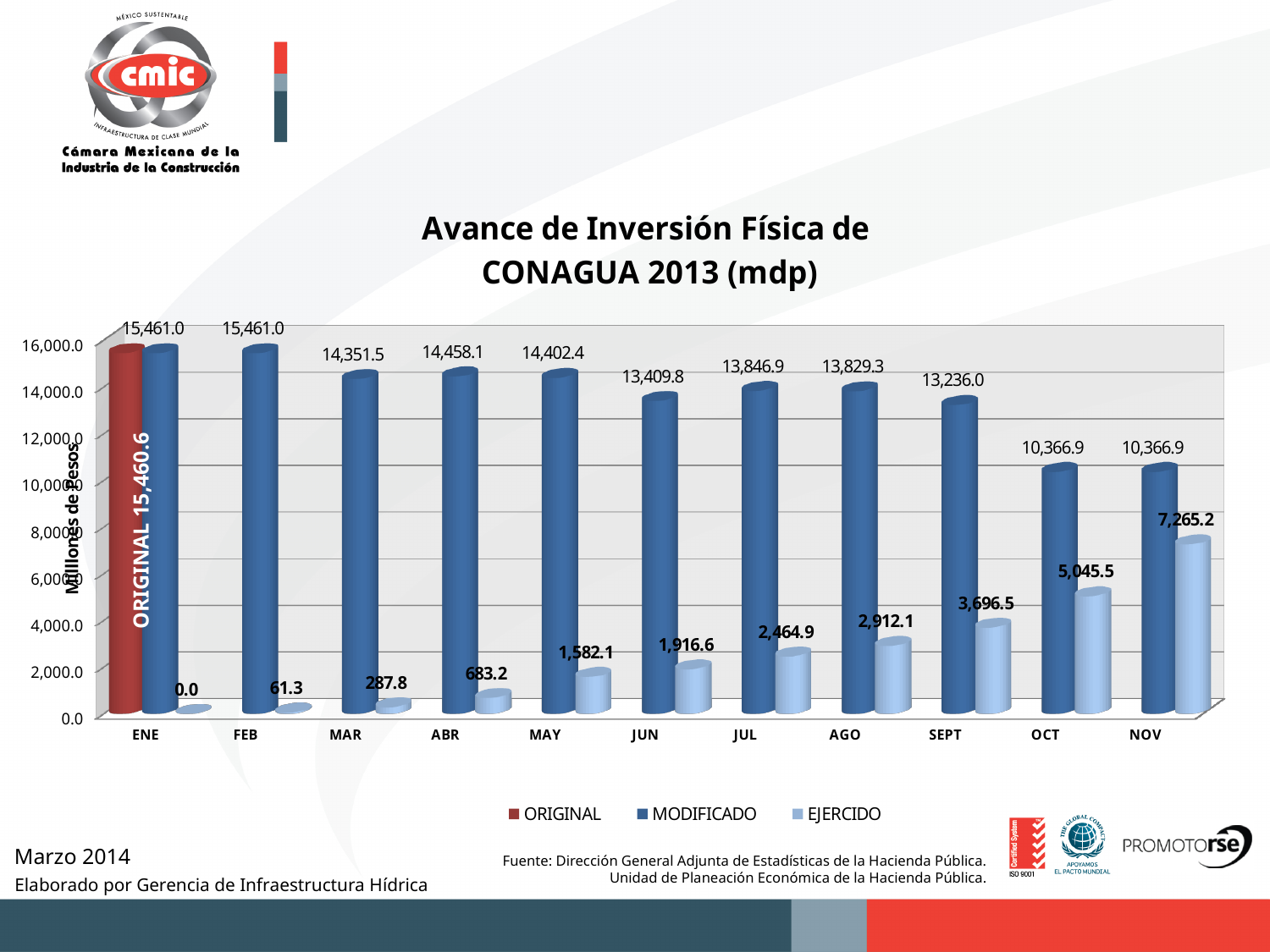
Is the MODIFICADO value for JUN greater or less than 14,000.0? less What kind of chart is shown on the slide? bar chart How many months are shown on the x axis? 11 What is the MODIFICADO value for MAR? 14,351.5 What is the difference between the MODIFICADO and EJERCIDO values for OCT? 5,321.4 What is the EJERCIDO value for NOV? 7,265.2 Do the EJERCIDO values rise or fall from ENE to NOV? rise Which month has the lowest MODIFICADO value? OCT and NOV (10,366.9) How many series does the legend list? 3 Which is larger, the EJERCIDO value for SEPT or for AGO? SEPT Which month has the highest EJERCIDO value? NOV What is the ORIGINAL value shown for ENE? 15,460.6